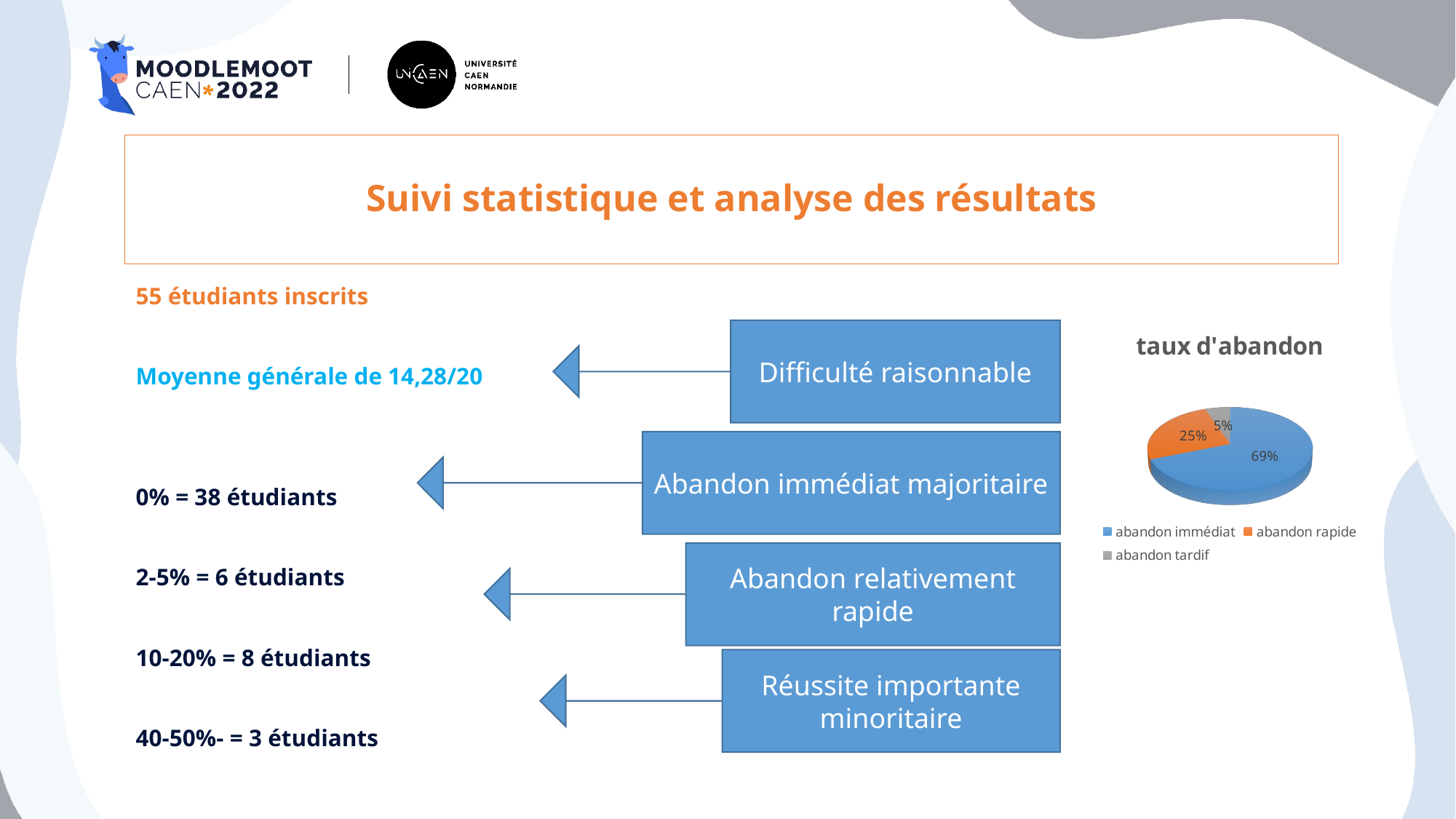
What colour is the "abandon rapide" slice in the pie chart? orange Which category has the largest slice of the pie? abandon immédiat What is the title of the chart on the slide? taux d'abandon How many entries does the legend of the pie chart list? 3 What type of chart is shown under the title "taux d'abandon"? pie chart What share of the pie does "abandon tardif" represent? 5% How many categories does the pie chart show? 3 What is the difference in percentage points between "abandon immédiat" and "abandon rapide"? 44 Which category has the smallest slice of the pie? abandon tardif What share of the pie does "abandon immédiat" represent? 69% Which is larger, the share for "abandon rapide" or the share for "abandon tardif"? abandon rapide What share of the pie does "abandon rapide" represent? 25%